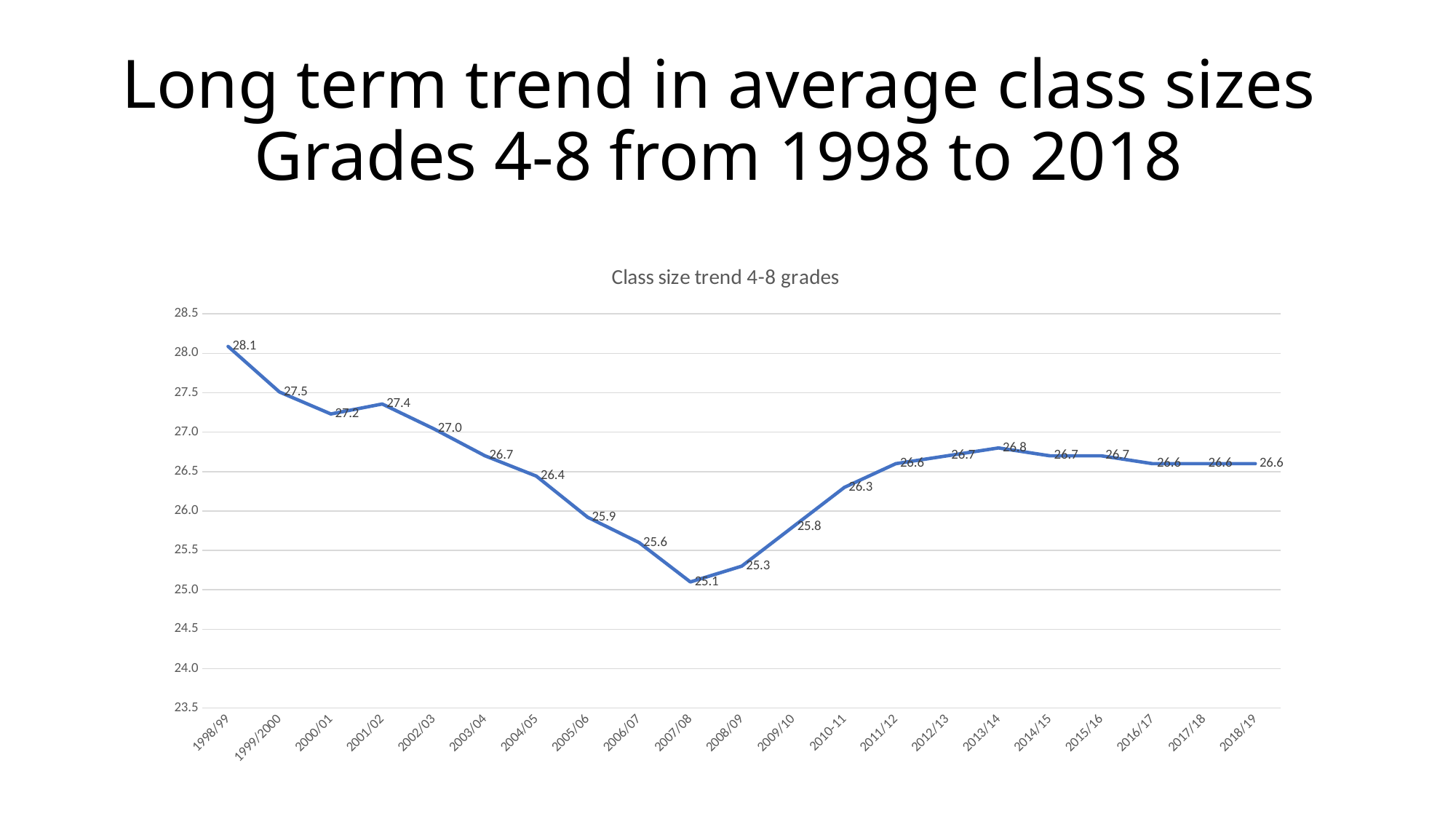
Which is larger, the average class size in 2001/02 or in 2004/05? 2001/02 Which school year has the highest average class size? 1998/99 What is the difference between the average class size in 1998/99 and in 2007/08? 3.0 Does the average class size rise or fall from 1998/99 to 2007/08? Fall What is the average class size for 1998/99? 28.1 How many school years are plotted on the chart? 21 What type of chart is shown on the slide? Line chart What is the average class size for 2007/08? 25.1 Which school year has the lowest average class size? 2007/08 What is the average class size for 2013/14? 26.8 What is the average class size for 2018/19? 26.6 What is the title of the chart? Class size trend 4-8 grades